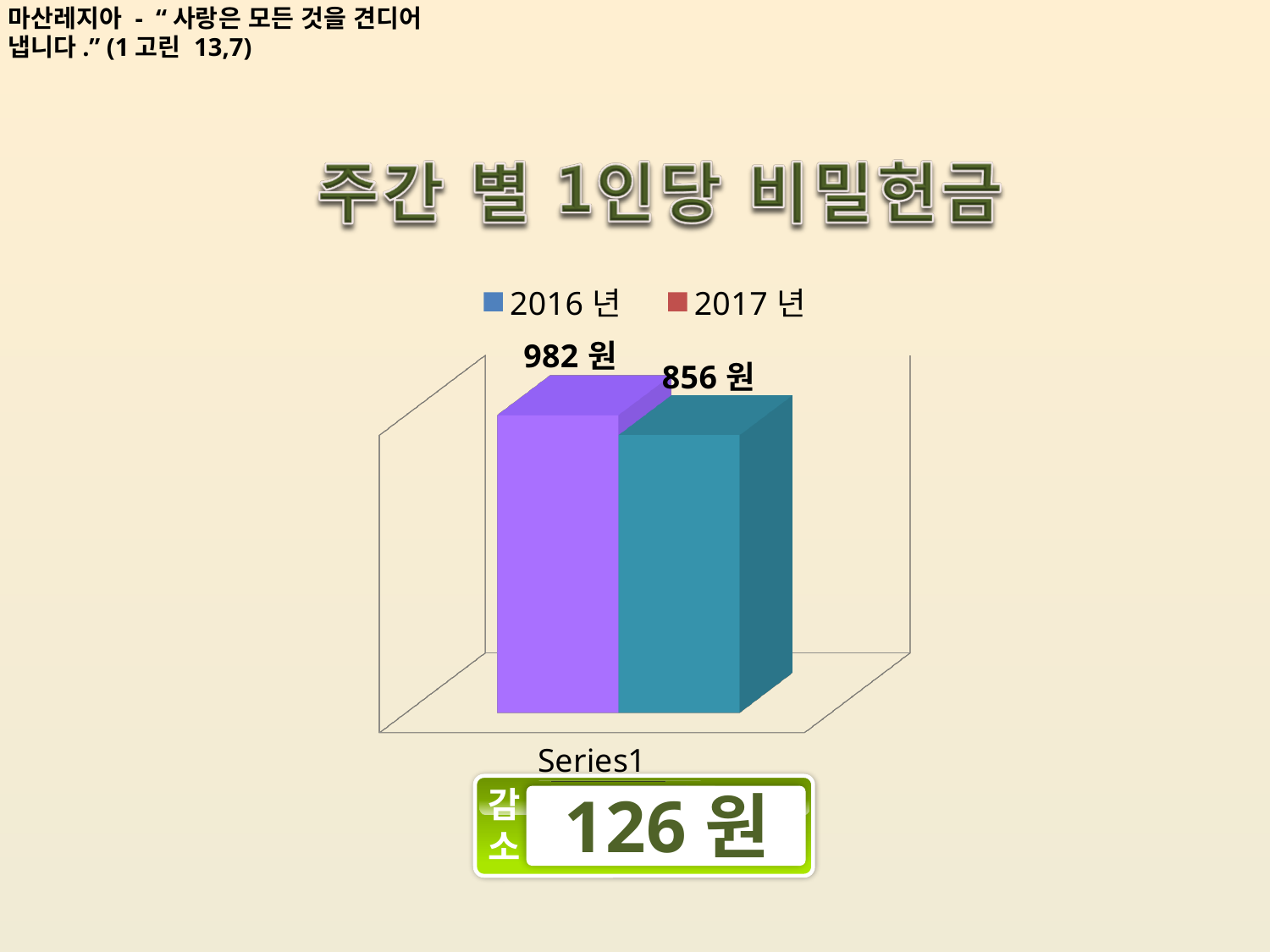
How many series does the legend list? 2 Did the value decrease or increase from 2016 년 to 2017 년? decrease What is the category label shown on the x axis of the chart? Series1 Is the value for 2016 년 larger or smaller than the value for 2017 년? larger Which year has the higher value in the chart? 2016 년 What is the value for 2017 년 in the chart? 856 원 What kind of chart is shown on the slide? bar chart What is the title of the chart? 주간 별 1인당 비밀헌금 What is the value for 2016 년 in the chart? 982 원 How many bars are plotted in the chart? 2 What is the difference between the 2016 년 and 2017 년 values? 126 원 Which year has the lower value in the chart? 2017 년